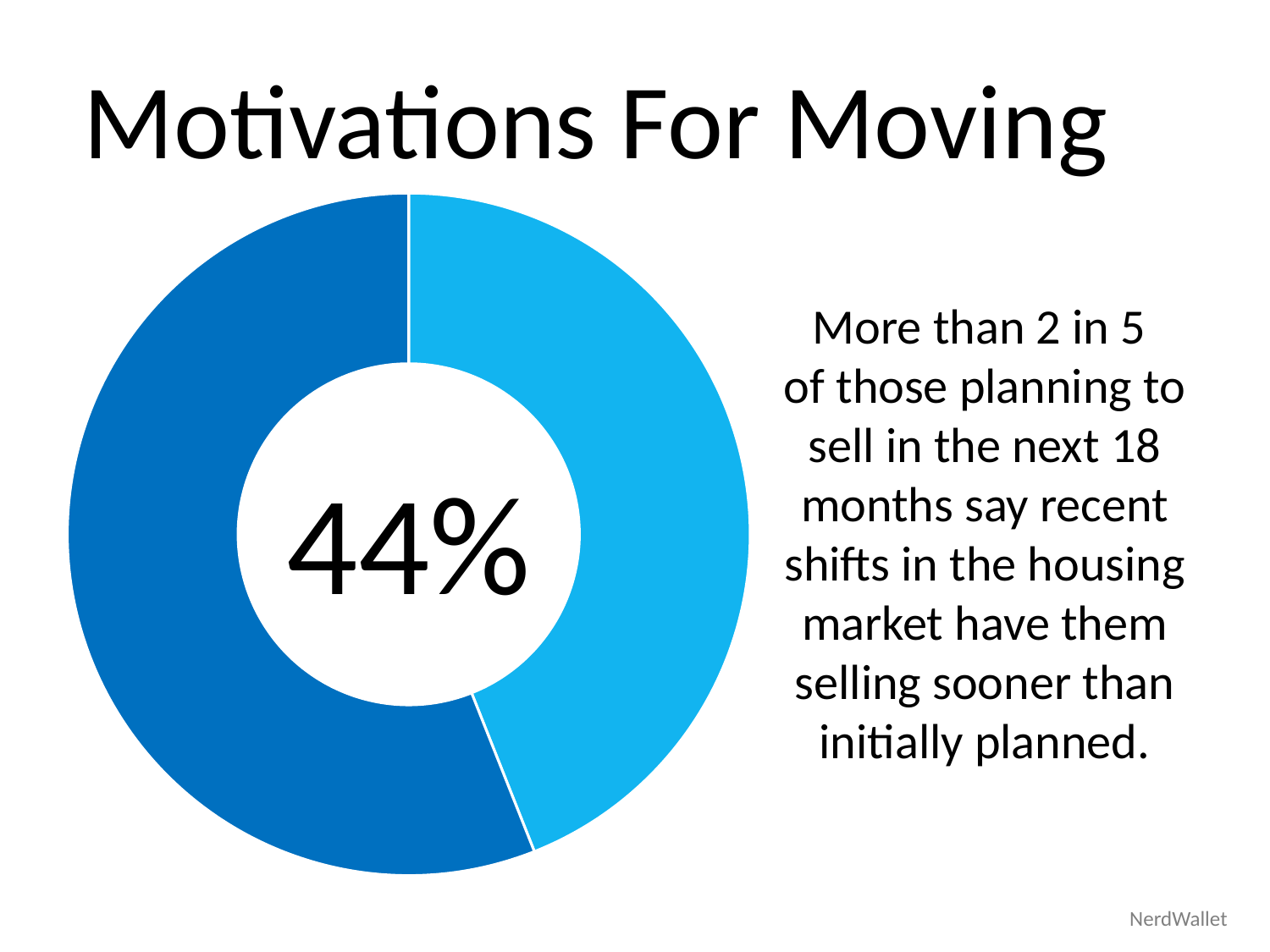
Which slice of the donut chart is larger, the light blue one or the dark blue one? Dark blue What share of the donut does the dark blue slice represent? 56% What kind of chart is shown on the slide? Donut (pie) chart What source is credited for the chart on the slide? NerdWallet How many slices does the donut chart have? 2 Is the light blue slice of the donut chart greater or less than 50% of the whole? less What share of the donut does the light blue slice represent? 44% What percentage is printed in the center of the donut chart? 44% Is the dark blue slice of the donut chart greater or less than 50% of the whole? greater What is the title of the slide containing the donut chart? Motivations For Moving